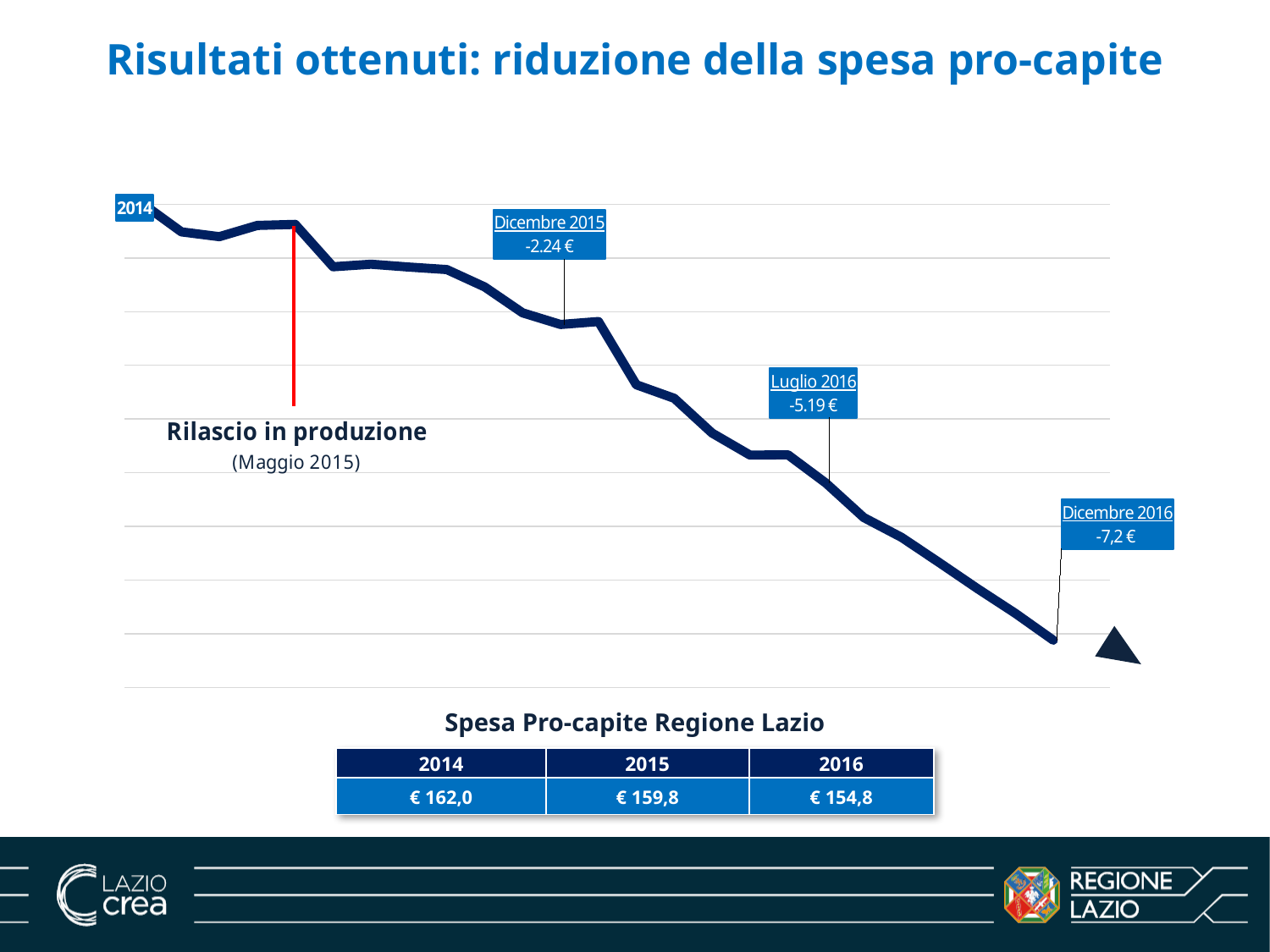
What kind of chart is shown on the slide? line chart In the table 'Spesa Pro-capite Regione Lazio', which year has the lowest value? 2016 What label appears at the starting point of the line on the left of the chart? 2014 Does the line in the chart rise or fall from left to right? fall What value is shown in the annotation labelled Luglio 2016? -5.19 € In the table 'Spesa Pro-capite Regione Lazio', what is the value for 2014? € 162,0 Which annotation shows the larger reduction, Luglio 2016 or Dicembre 2016? Dicembre 2016 In the table 'Spesa Pro-capite Regione Lazio', what is the value for 2016? € 154,8 How many annotated points with euro values are marked on the line? 3 What event does the red vertical line on the chart mark? Rilascio in produzione (Maggio 2015) What value is shown in the annotation labelled Dicembre 2016? -7,2 € What value is shown in the annotation labelled Dicembre 2015? -2.24 €